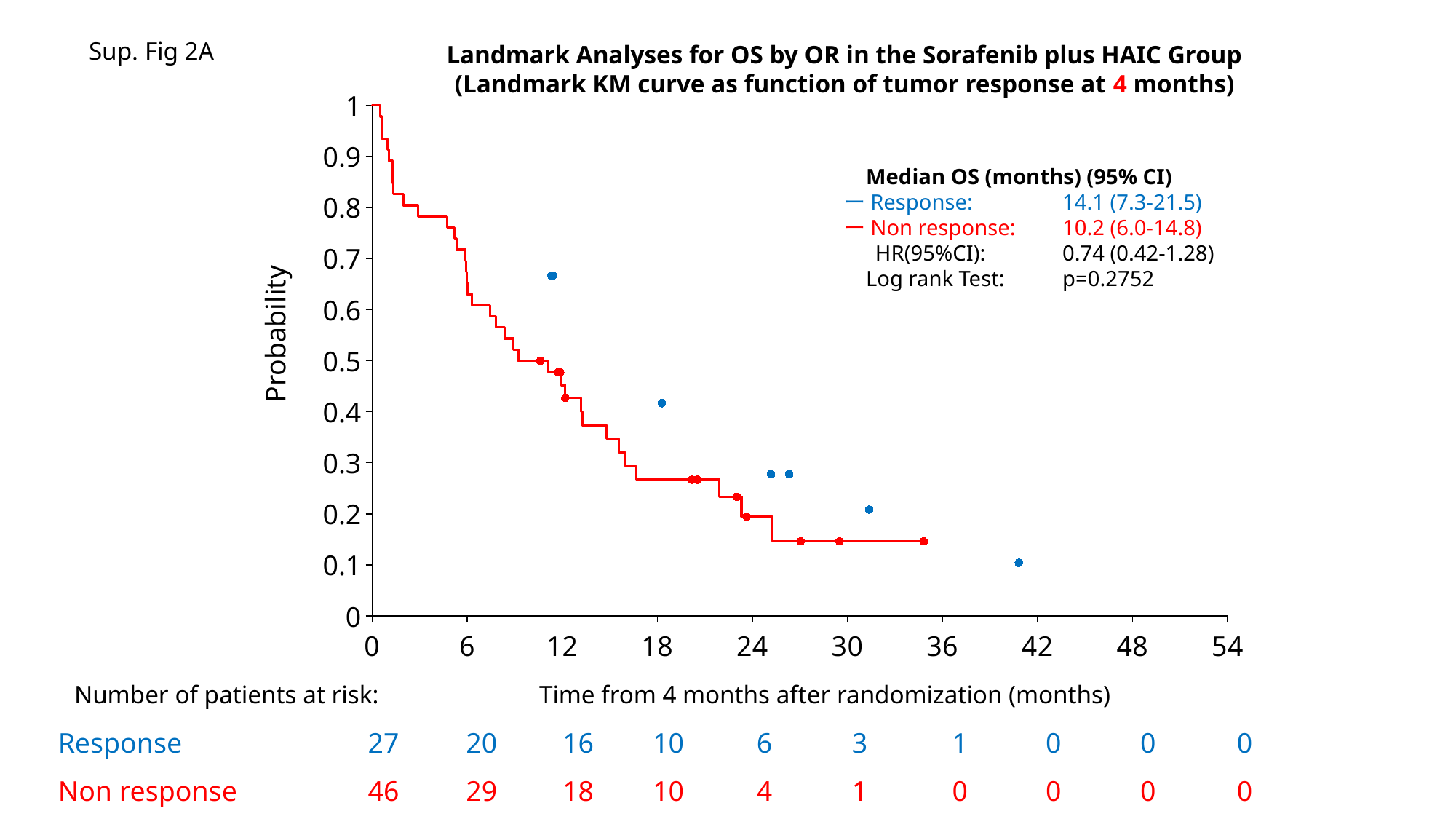
What is the median OS in months for the Response group? 14.1 (7.3-21.5) What kind of chart is shown on the slide? Kaplan-Meier survival curve (step line chart) What is the log rank test p-value shown on the chart? p=0.2752 What is the median OS in months for the Non response group? 10.2 (6.0-14.8) Is the Non response curve's probability at 6 months greater or less than 0.5? greater Which group has the higher median OS, Response or Non response? Response Is the Non response curve's probability at 30 months greater or less than 0.2? less How many Response patients are at risk at 18 months? 10 How many groups does the legend list? 2 How many Non response patients are at risk at time 0? 46 What is the difference in the number of patients at risk at time 0 between the Non response and Response groups? 19 What is the hazard ratio with 95% CI shown on the chart? 0.74 (0.42-1.28)